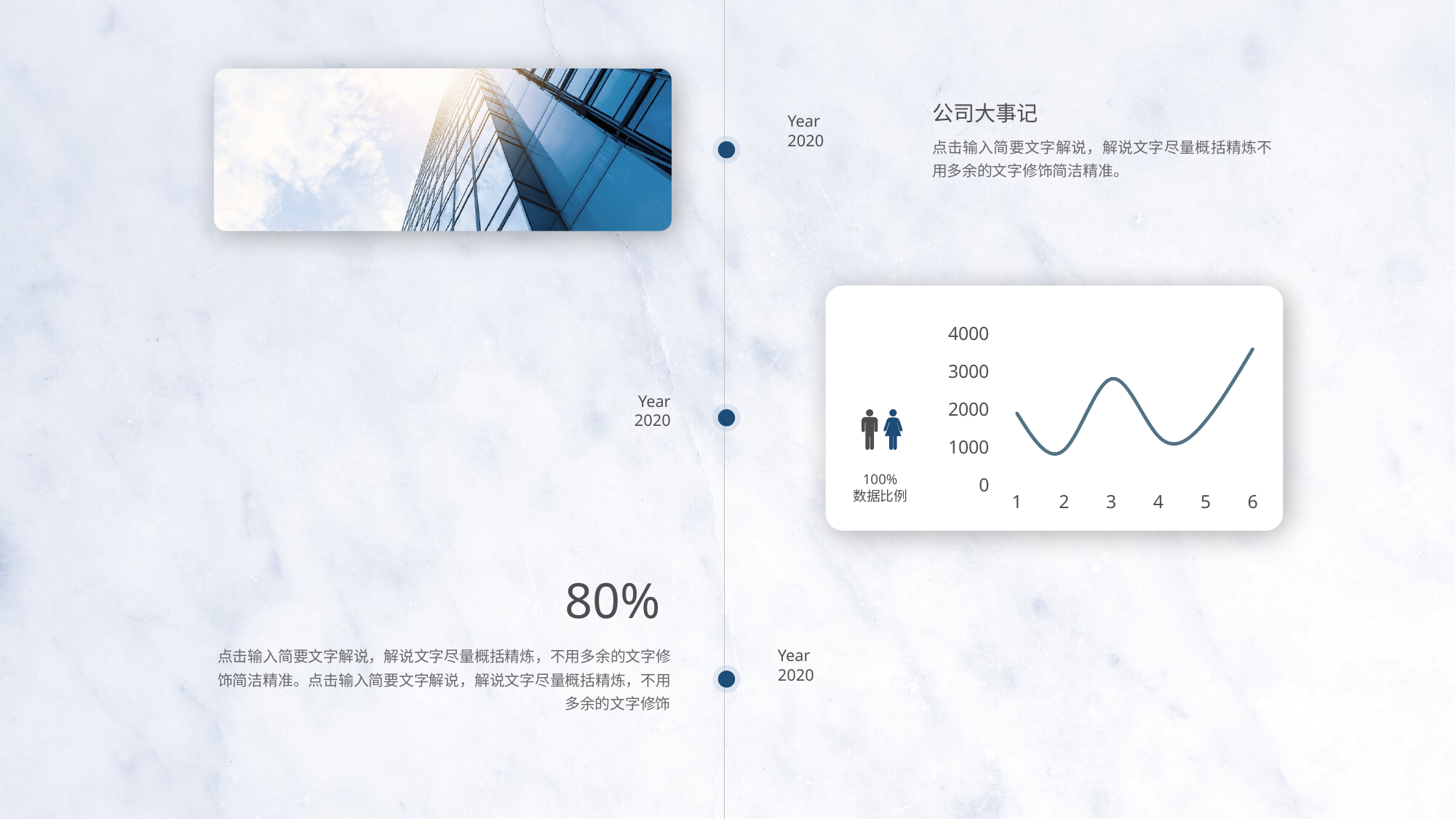
Does the line rise or fall between x = 4 and x = 6? rise What is the highest tick value shown on the y axis of the line chart? 4000 Which has the larger value, x = 3 or x = 1? 3 Is the value at x = 6 greater or less than 3000? greater Which has the larger value, x = 6 or x = 3? 6 Is the value at x = 3 greater or less than 2000? greater Is the value at x = 4 greater or less than 2000? less At which x-axis category does the line chart reach its highest value? 6 At which x-axis category does the line chart reach its lowest value? 2 How many points are plotted along the x axis of the line chart? 6 What kind of chart is shown on the slide? line chart